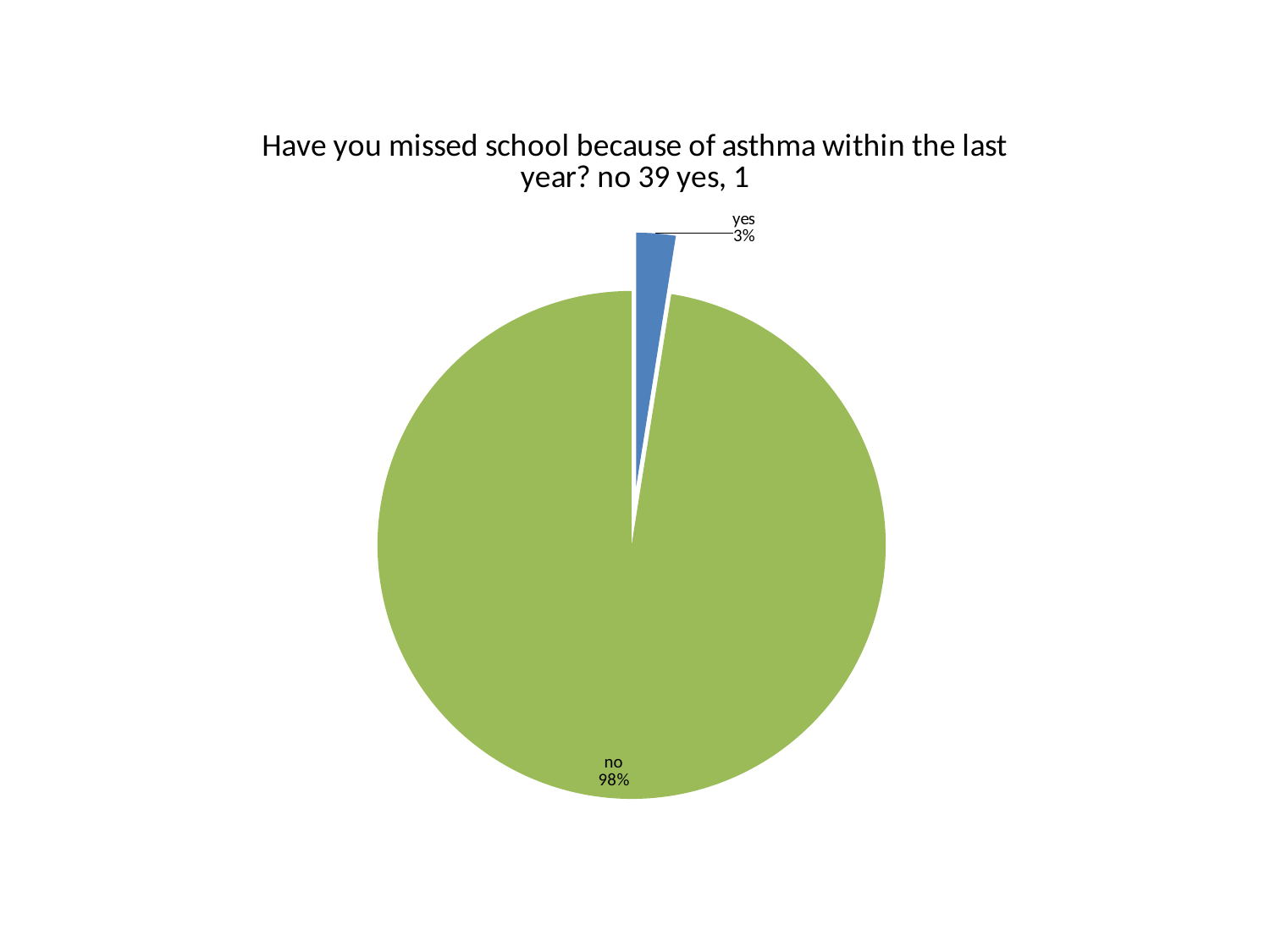
Which category has the smallest slice of the pie? yes Which slice is larger, "yes" or "no"? no What colour is the "yes" slice? blue What type of chart is shown on the slide? pie chart How many slices does the pie chart have? 2 What percentage share does the "yes" slice have? 3% Which category has the largest slice of the pie? no What percentage share does the "no" slice have? 98% What is the title of the chart? Have you missed school because of asthma within the last year? no 39 yes, 1 What is the difference in percentage points between the "no" and "yes" slices? 95